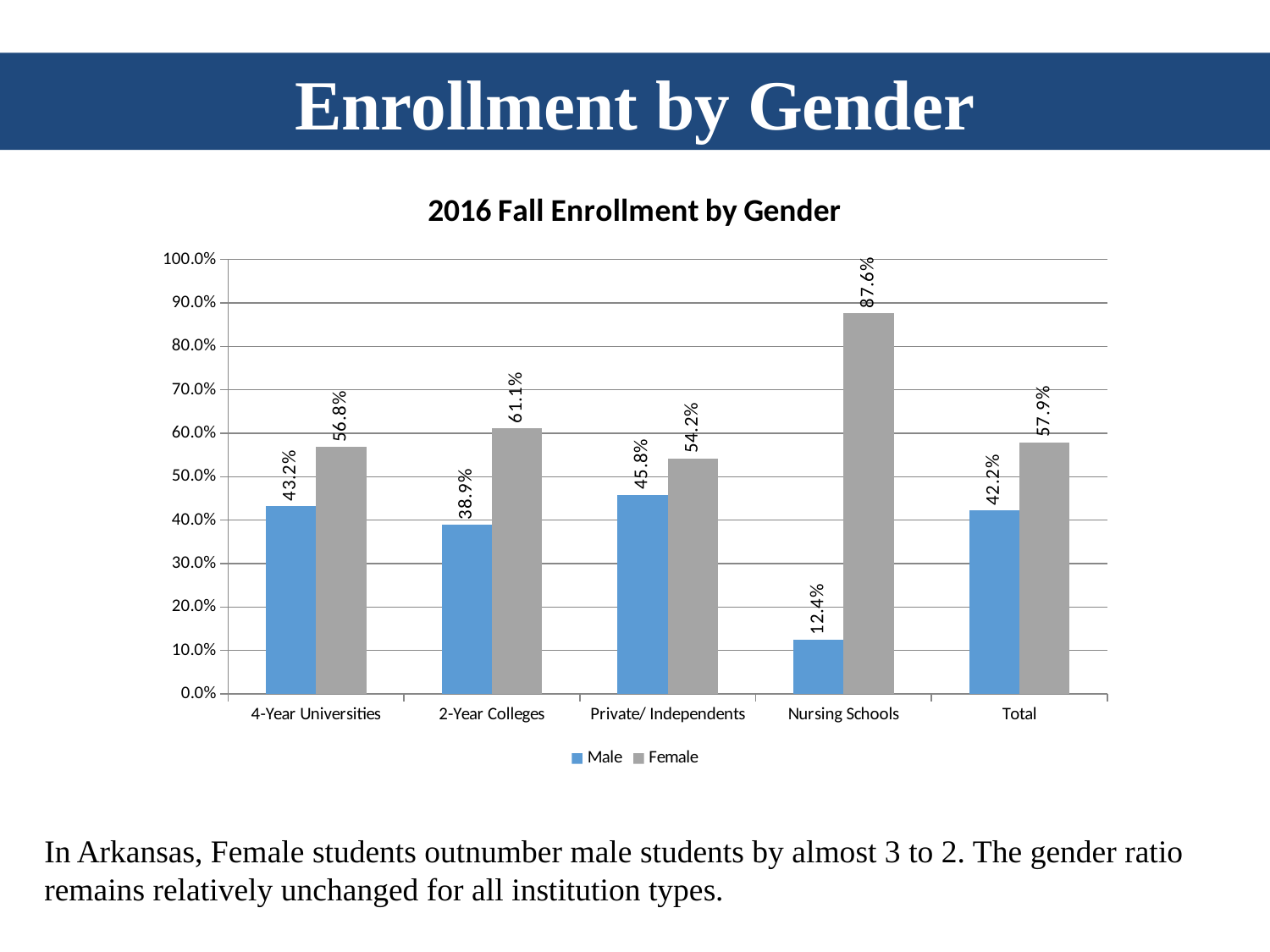
What is the Female enrollment percentage for 2-Year Colleges? 61.1% What is the Female enrollment percentage for Nursing Schools? 87.6% What is the title of the chart? 2016 Fall Enrollment by Gender Which is larger, the Male percentage for 4-Year Universities or the Male percentage for 2-Year Colleges? 4-Year Universities Which institution type has the lowest Male enrollment percentage? Nursing Schools How many series does the legend list? 2 What type of chart is shown on the slide? Bar chart What is the difference between the Female and Male percentages for Private/ Independents? 8.4% What is the Male enrollment percentage for 4-Year Universities? 43.2% Which institution type has the highest Female enrollment percentage? Nursing Schools How many institution categories are shown on the x axis? 5 What is the Male enrollment percentage for the Total category? 42.2%